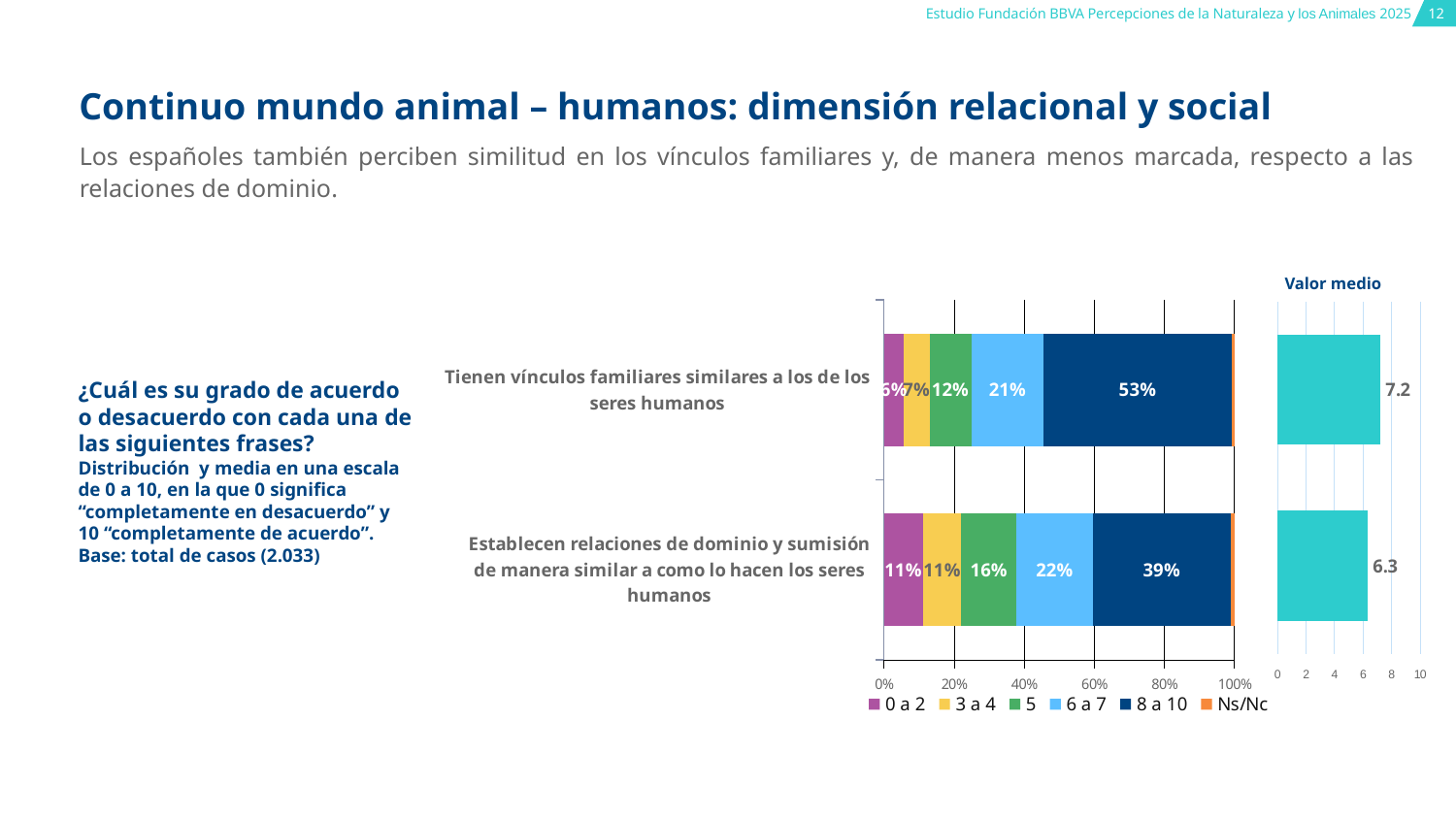
In the stacked bar chart, which statement has the larger share of 8 a 10 responses? Tienen vínculos familiares similares a los de los seres humanos In the Valor medio chart, what is the mean value for "Tienen vínculos familiares similares a los de los seres humanos"? 7.2 In the stacked bar chart, what percentage gave a score of 8 a 10 for "Establecen relaciones de dominio y sumisión de manera similar a como lo hacen los seres humanos"? 39% How many statements (categories) are shown in the stacked bar chart? 2 In the stacked bar chart, what is the difference between the 8 a 10 shares of the two statements? 14 percentage points In the stacked bar chart, what percentage gave a score of 6 a 7 for "Tienen vínculos familiares similares a los de los seres humanos"? 21% In the stacked bar chart, what percentage gave a score of 8 a 10 for "Tienen vínculos familiares similares a los de los seres humanos"? 53% In the Valor medio chart, what is the mean value for "Establecen relaciones de dominio y sumisión de manera similar a como lo hacen los seres humanos"? 6.3 In the Valor medio chart, what is the difference between the two mean values shown? 0.9 How many series does the legend of the stacked bar chart list? 6 What type of chart is the Valor medio chart? Bar chart In the stacked bar chart, what percentage gave a score of 5 for "Establecen relaciones de dominio y sumisión de manera similar a como lo hacen los seres humanos"? 16%